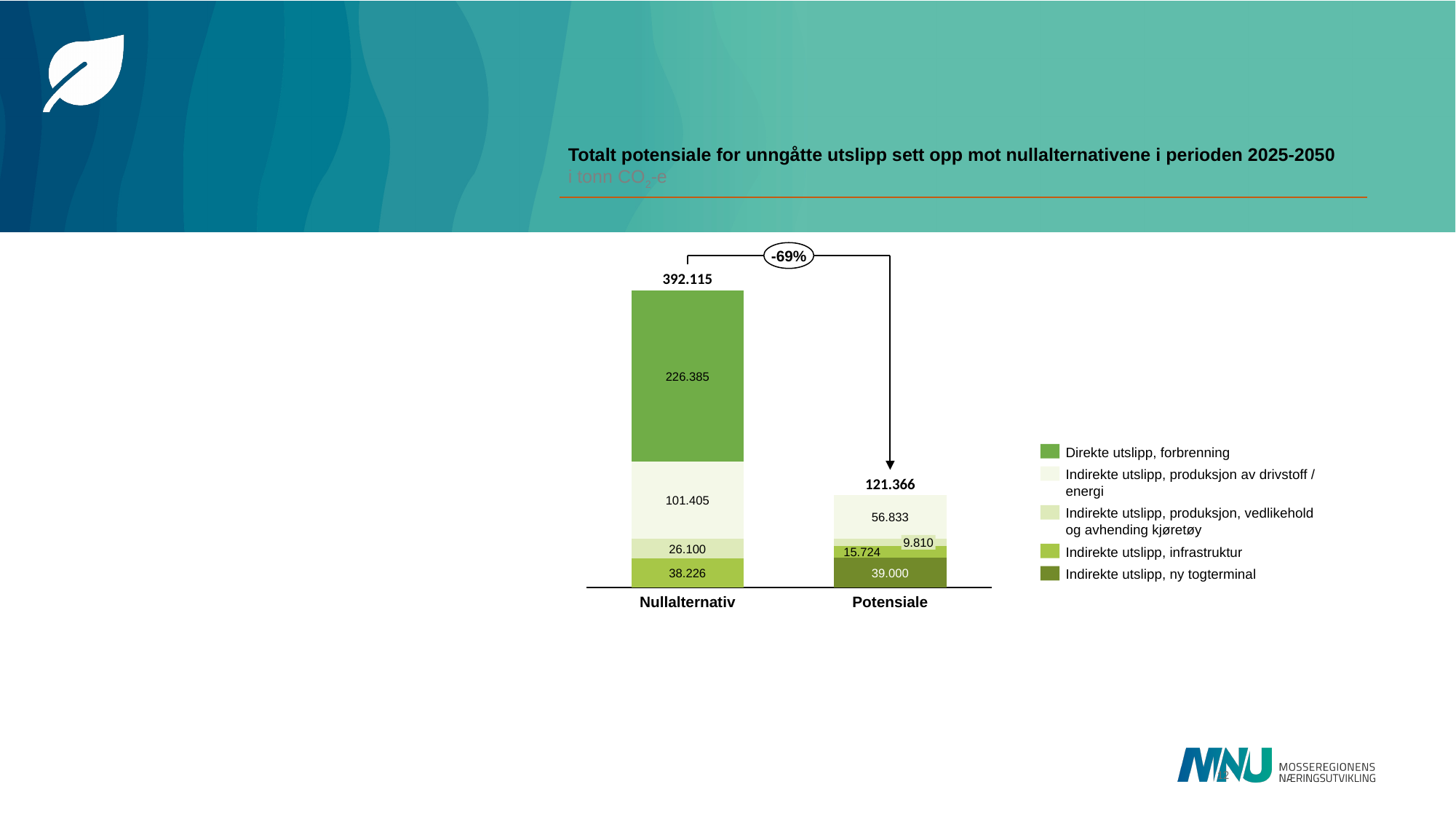
How many series does the legend list? 5 What is the total value printed above the Nullalternativ bar? 392.115 Which bar has the larger total, Nullalternativ or Potensiale? Nullalternativ How many categories are shown on the x axis of the chart? 2 What is the value of 'Indirekte utslipp, infrastruktur' for Potensiale? 15.724 What is the difference between the total for Nullalternativ and the total for Potensiale? 270.749 What percentage change is shown in the circle between the two bars? -69% What is the difference in 'Indirekte utslipp, produksjon av drivstoff / energi' between Nullalternativ and Potensiale? 44.572 What kind of chart is shown on the slide? Stacked bar chart What is the value of 'Direkte utslipp, forbrenning' for Nullalternativ? 226.385 What is the total value printed above the Potensiale bar? 121.366 What is the value of 'Indirekte utslipp, ny togterminal' for Potensiale? 39.000